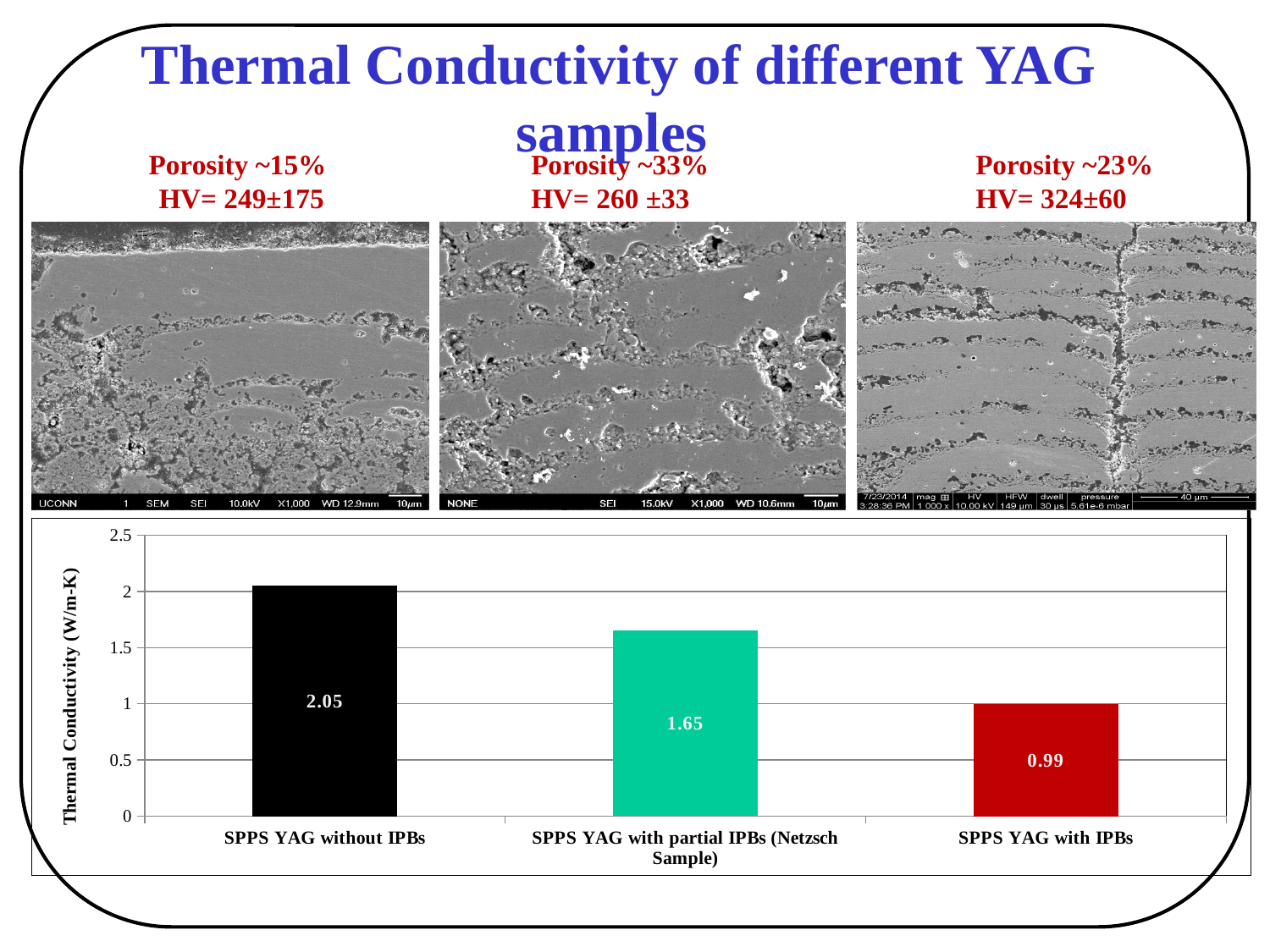
Which has a higher thermal conductivity, SPPS YAG with partial IPBs (Netzsch Sample) or SPPS YAG with IPBs? SPPS YAG with partial IPBs (Netzsch Sample) Which sample has the highest thermal conductivity? SPPS YAG without IPBs What is the difference in thermal conductivity between SPPS YAG without IPBs and SPPS YAG with IPBs? 1.06 What is the thermal conductivity value for SPPS YAG with partial IPBs (Netzsch Sample)? 1.65 What is the thermal conductivity value for SPPS YAG with IPBs? 0.99 How many samples are plotted in the bar chart? 3 What is the difference in thermal conductivity between SPPS YAG without IPBs and SPPS YAG with partial IPBs (Netzsch Sample)? 0.40 Which sample has the lowest thermal conductivity? SPPS YAG with IPBs What kind of chart is used to show the thermal conductivity values? bar chart What is the label of the y axis of the chart? Thermal Conductivity (W/m-K) Is the thermal conductivity for SPPS YAG with IPBs greater or less than 1.5? less What is the thermal conductivity value for SPPS YAG without IPBs? 2.05